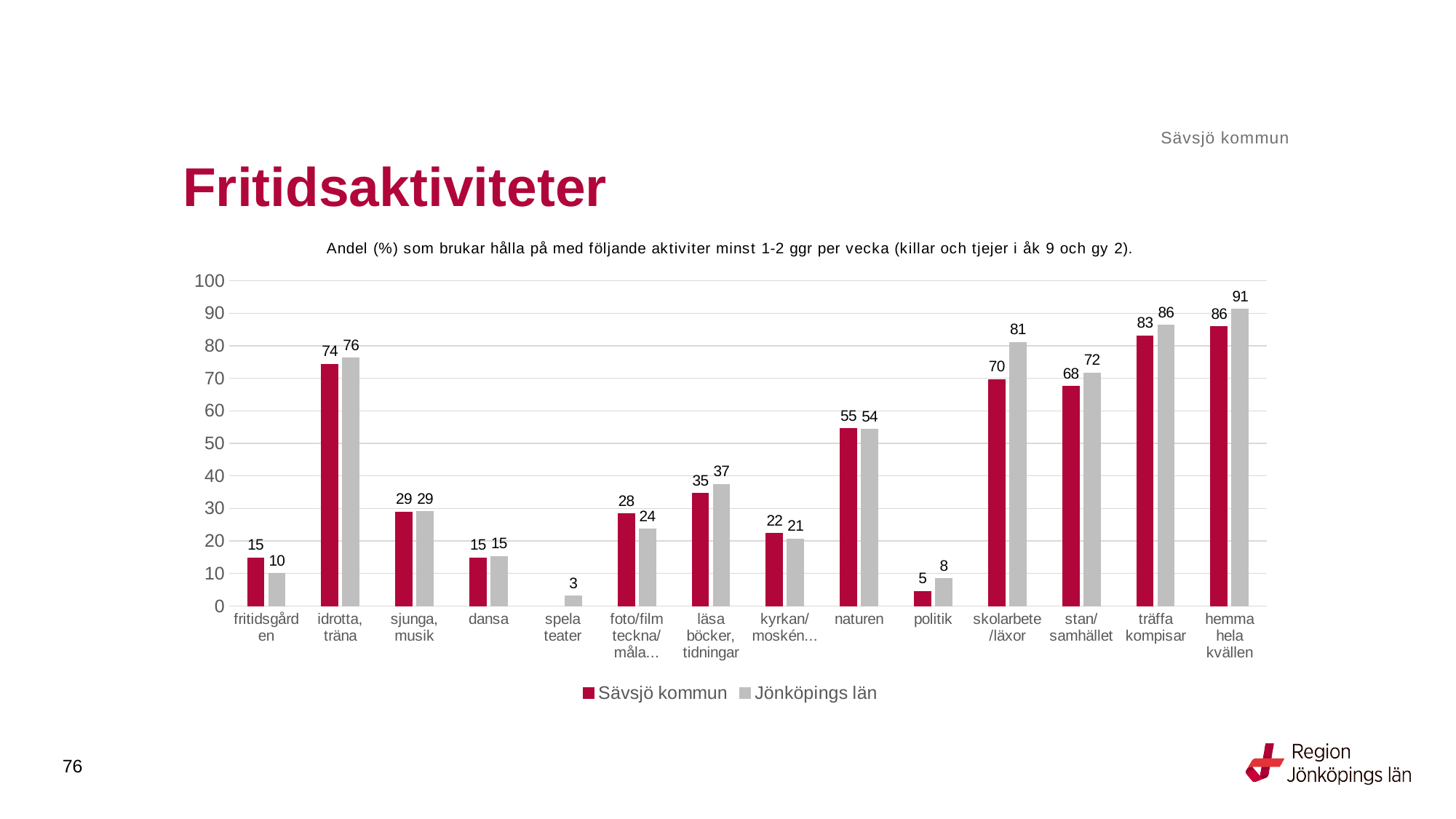
How many series does the legend list? 2 Is the value for Sävsjö kommun for 'träffa kompisar' greater or less than 80? greater What type of chart is shown on the slide? bar chart Which series is shown in red? Sävsjö kommun What is the difference between Jönköpings län and Sävsjö kommun for 'skolarbete/läxor'? 11 What is the value for Jönköpings län for 'hemma hela kvällen'? 91 Which category has the highest value for Sävsjö kommun? hemma hela kvällen How many activity categories are shown on the x axis? 14 For 'fritidsgården', which is larger: Sävsjö kommun or Jönköpings län? Sävsjö kommun Which category has the lowest value for Jönköpings län? spela teater What is the value for Sävsjö kommun for 'skolarbete/läxor'? 70 What is the value for Sävsjö kommun for 'politik'? 5